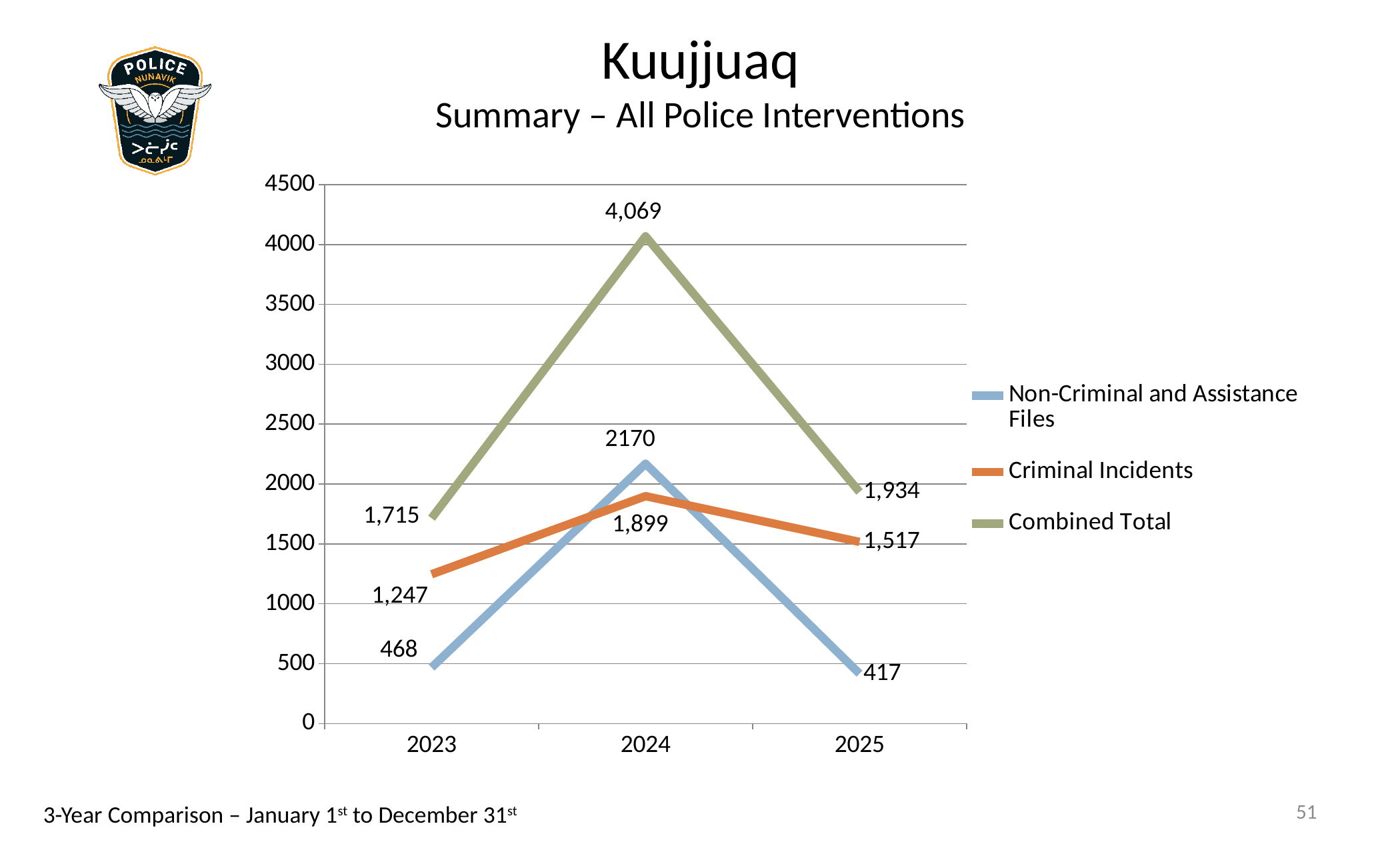
What is the value for Criminal Incidents in 2023? 1,247 How many series does the legend list? 3 What kind of chart is shown on the slide? Line chart What is the value for Non-Criminal and Assistance Files in 2024? 2170 In which year is the Combined Total highest? 2024 In which year is the value for Non-Criminal and Assistance Files lowest? 2025 What is the difference between the Combined Total in 2024 and in 2023? 2,354 Which is larger in 2024: Non-Criminal and Assistance Files or Criminal Incidents? Non-Criminal and Assistance Files What is the value for Criminal Incidents in 2025? 1,517 Does the Criminal Incidents series rise or fall from 2024 to 2025? Fall What is the Combined Total for 2025? 1,934 How many years are shown on the x axis? 3